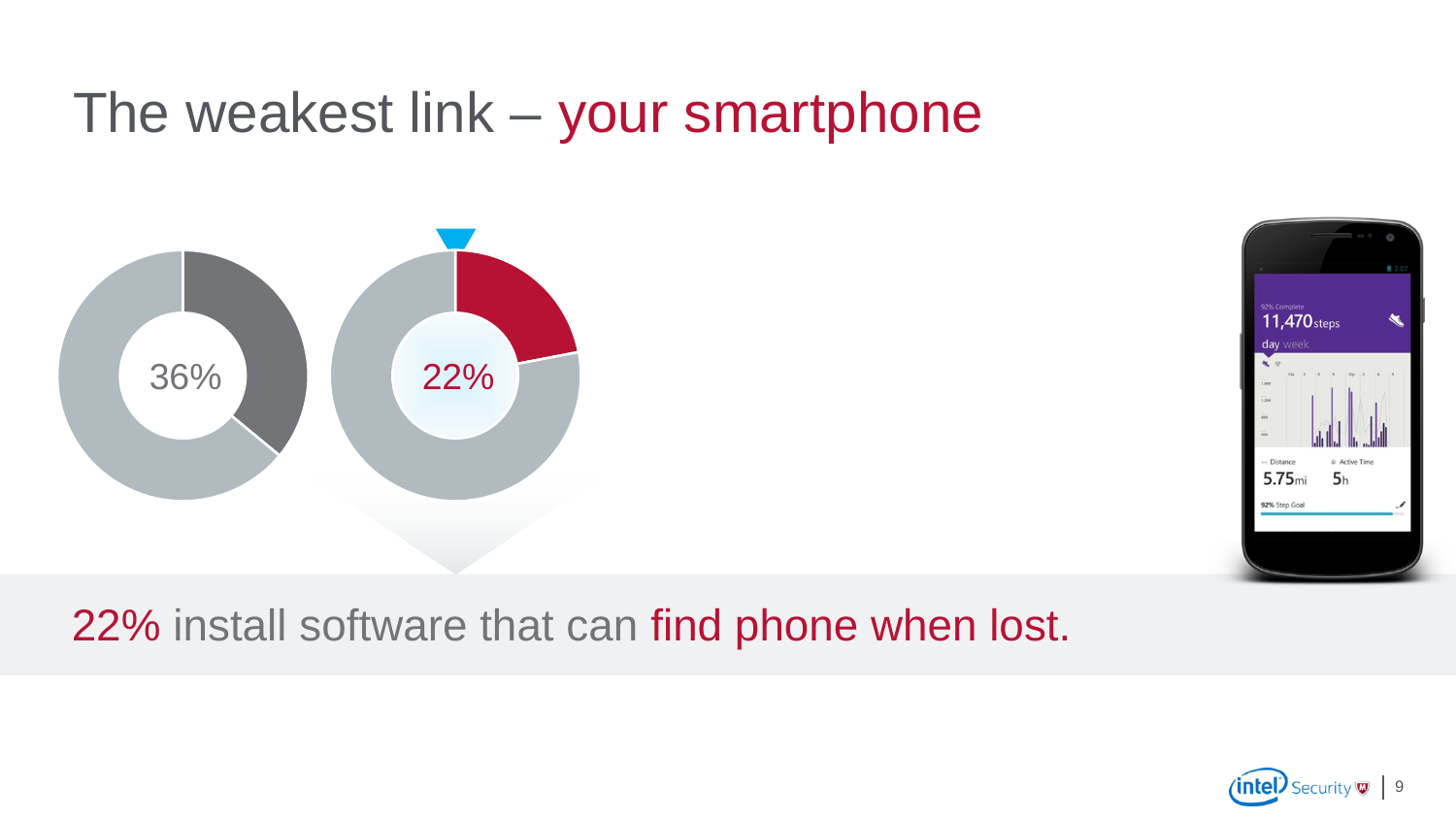
Which donut chart shows the larger percentage, the left one or the right one? the left one Is the value shown in the left donut chart greater or less than 30%? greater What percentage is shown in the centre of the left donut chart? 36% Is the value shown in the right donut chart greater or less than 25%? less How many donut charts are shown on the slide? 2 According to the slide, what percentage install software that can find the phone when lost? 22% What colour is the highlighted slice in the right donut chart? red What kind of chart is the right chart on the slide? donut chart In the right donut chart, what share of the whole does the red slice represent? 22% What percentage is shown in the centre of the right donut chart? 22% What kind of chart is the left chart on the slide? donut chart What is the difference between the percentage in the left donut chart and the percentage in the right donut chart? 14%